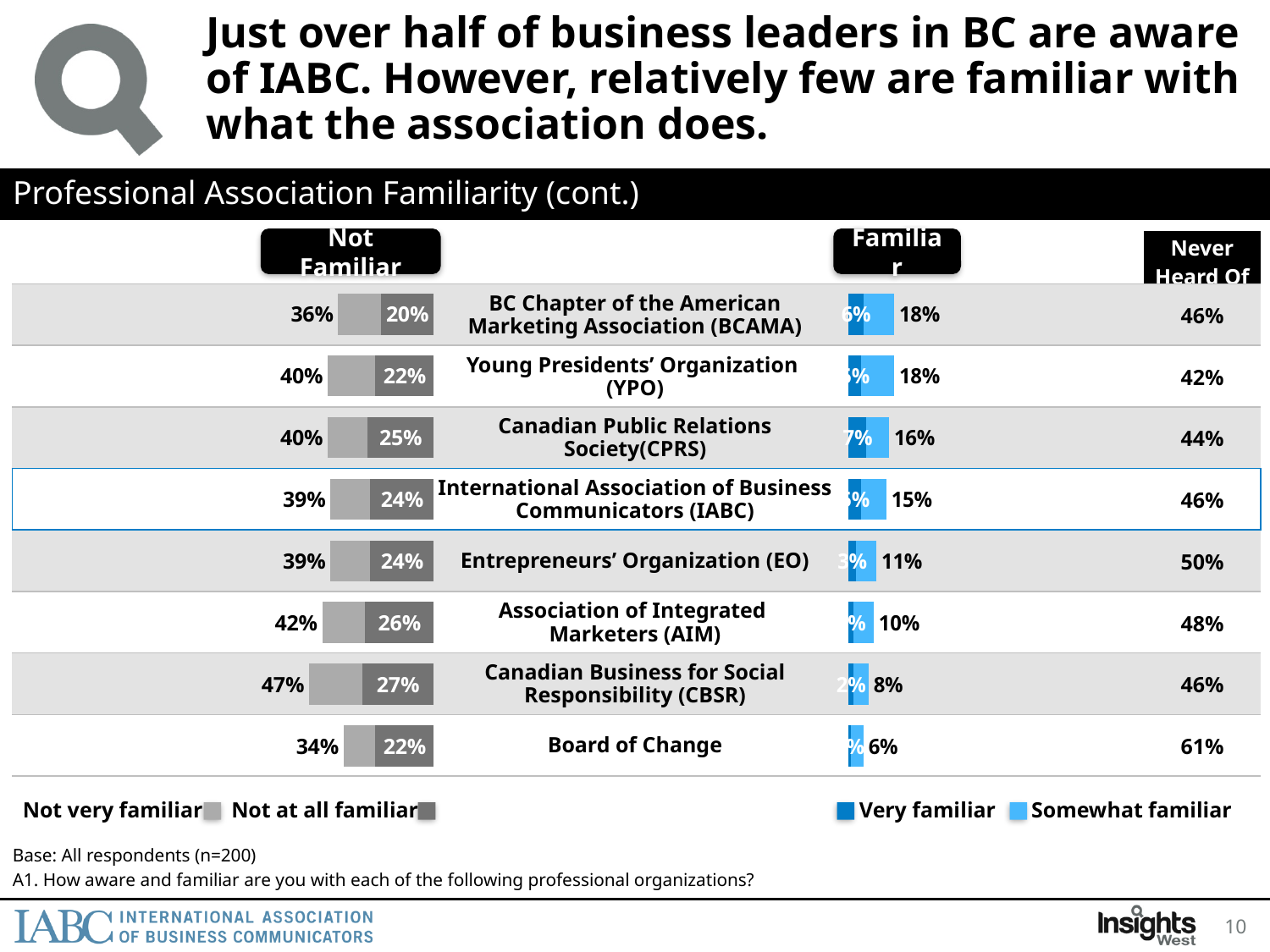
What is the difference in 'Never Heard Of' percentage between Entrepreneurs' Organization (EO) and Young Presidents' Organization (YPO)? 8 percentage points What is the 'Not at all familiar' value for Canadian Business for Social Responsibility (CBSR)? 27% How many professional organizations are listed in the chart? 8 Which organization has the highest 'Not at all familiar' percentage? Canadian Business for Social Responsibility (CBSR) How many series are listed in the chart's legends? 4 What kind of chart is shown on the slide? Bar chart Which organization has the lowest 'Somewhat familiar' percentage? Board of Change Which has a higher 'Somewhat familiar' value: BC Chapter of the American Marketing Association (BCAMA) or Association of Integrated Marketers (AIM)? BC Chapter of the American Marketing Association (BCAMA) What percentage of respondents have never heard of Board of Change? 61% Which organization has the highest 'Never Heard Of' percentage? Board of Change Do the 'Somewhat familiar' values rise or fall going down the list from BCAMA to Board of Change? Fall